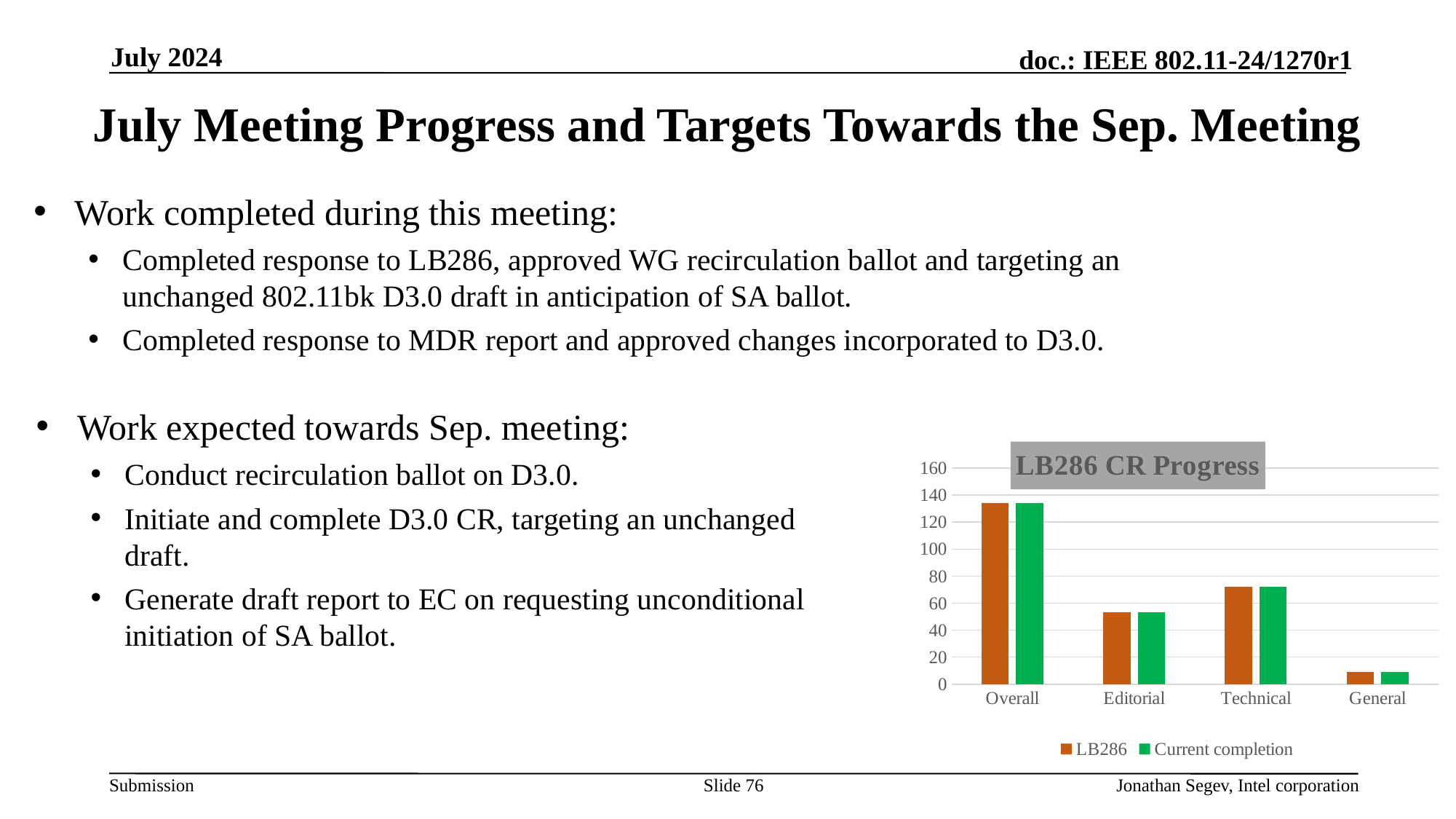
What kind of chart is shown on the slide? bar chart Is the LB286 value for Overall greater or less than 120? greater What is the title of the chart? LB286 CR Progress How many series does the chart's legend list? 2 Is the Current completion value for Technical greater or less than 60? greater Is the LB286 value for General greater or less than 20? less Which category has the lowest bars in the chart? General Which category has the highest bars in the chart? Overall Which category has a larger LB286 value, Technical or Editorial? Technical How many categories are shown on the x axis of the chart? 4 What are the two series named in the chart's legend? LB286 and Current completion